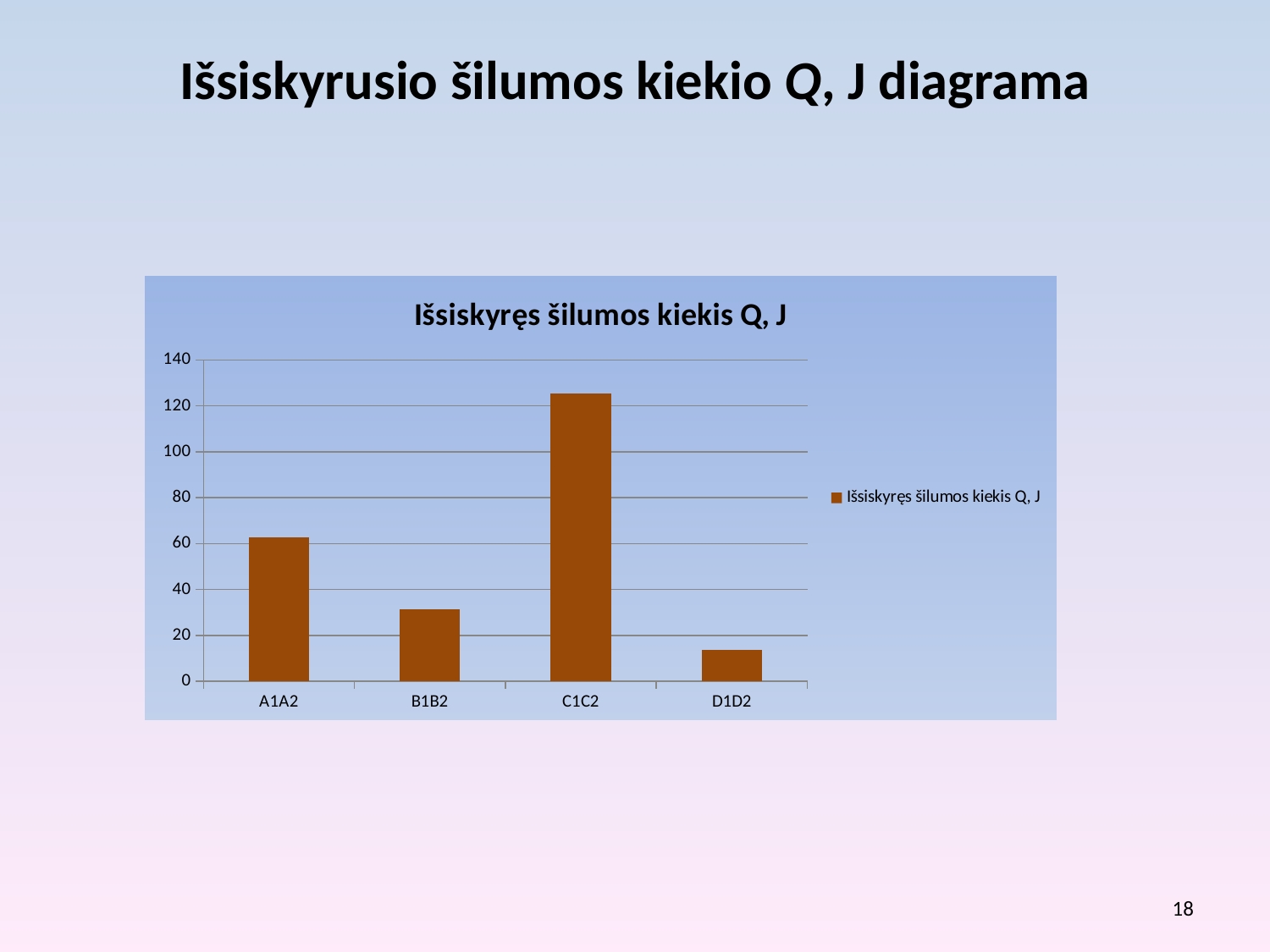
Which is larger, the value for A1A2 or the value for B1B2? A1A2 Is the value for B1B2 greater or less than 20? greater Is the value for D1D2 greater or less than 20? less Is the value for C1C2 greater or less than 100? greater What is the title of the chart? Išsiskyręs šilumos kiekis Q, J What kind of chart is shown on the slide? bar chart How many categories are shown on the x axis of the chart? 4 Which category has the lowest value in the chart? D1D2 Which category has the highest value in the chart? C1C2 How many series does the legend list? 1